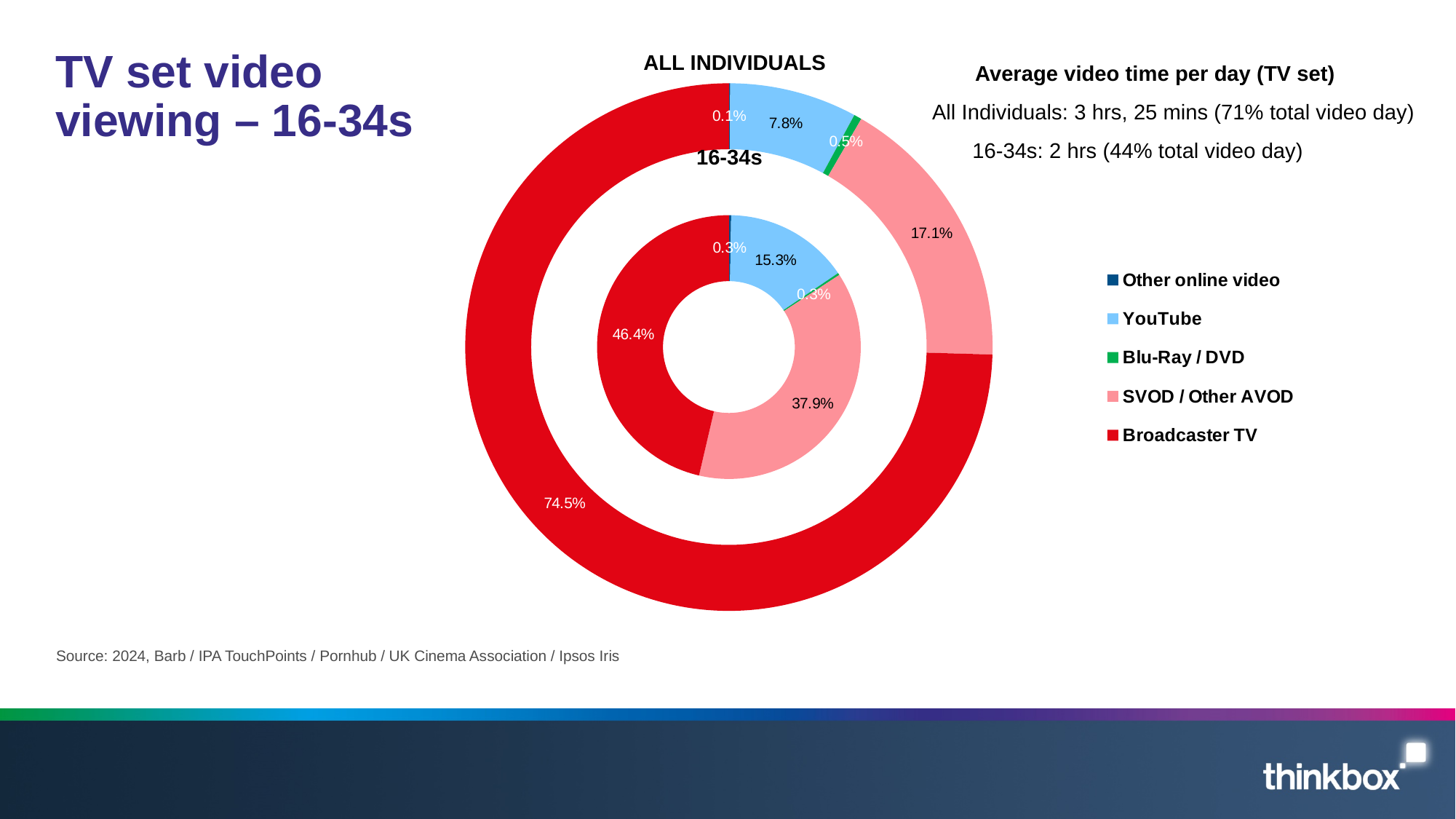
What kind of chart is shown on the slide? Doughnut chart Which colour represents Blu-Ray / DVD in the chart? Green What share of TV set video viewing does Broadcaster TV account for among 16-34s (inner ring)? 46.4% Which category has the smallest share in the all individuals ring? Other online video What share of TV set video viewing does Broadcaster TV account for among all individuals (outer ring)? 74.5% How many categories does the legend list? 5 What is the difference between the Broadcaster TV share for all individuals and for 16-34s? 28.1 percentage points Is the YouTube share larger for all individuals or for 16-34s? 16-34s Which category has the largest share in the 16-34s ring? Broadcaster TV What is the SVOD / Other AVOD share for all individuals in the outer ring? 17.1% What is the YouTube share for 16-34s in the inner ring? 15.3% What is the difference between the SVOD / Other AVOD share for 16-34s and for all individuals? 20.8 percentage points